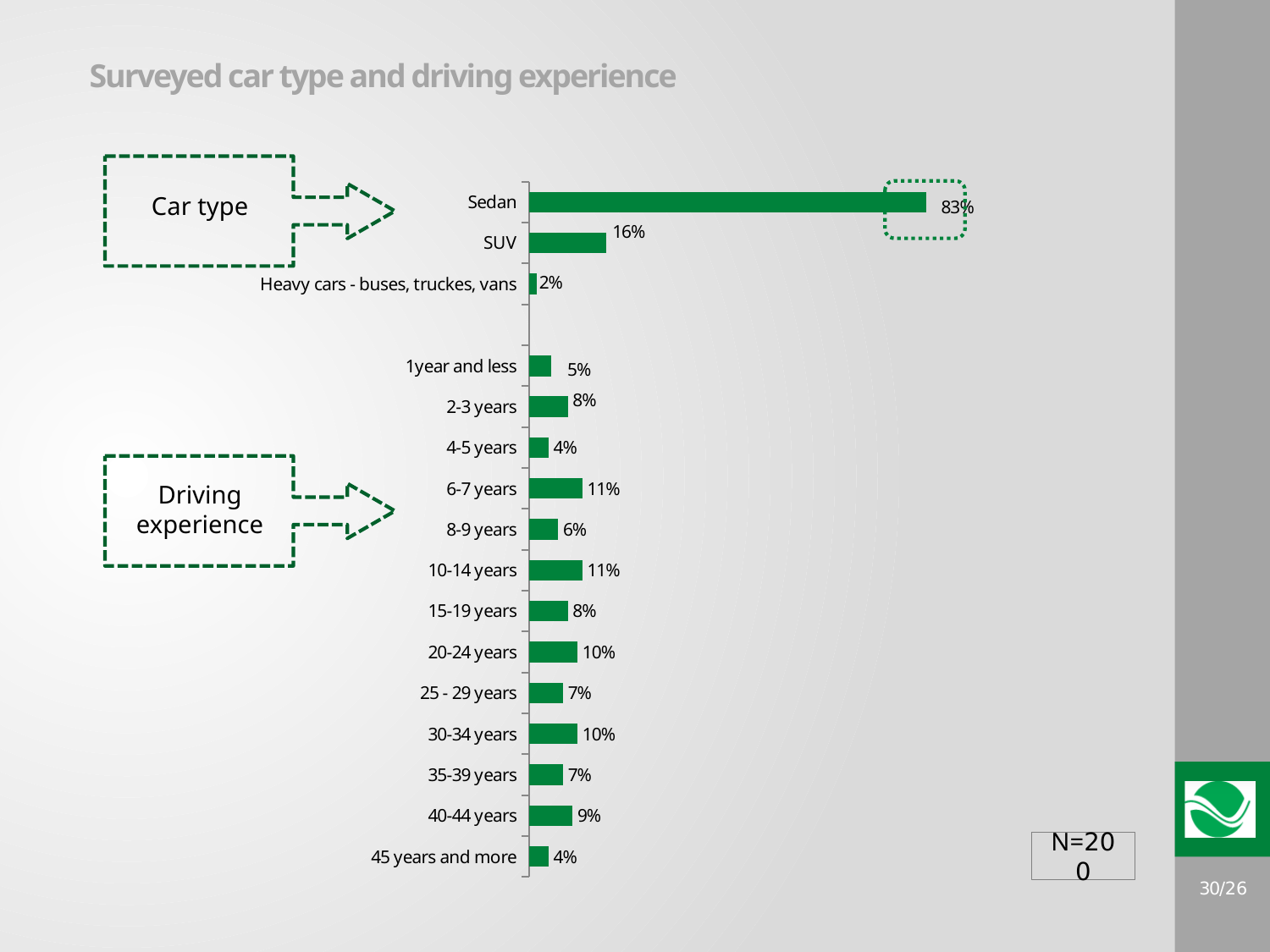
What is the difference between the Sedan and SUV percentages? 67% What is the value shown for SUV? 16% What percentage of surveyed drivers drive a Sedan? 83% What is the title of the slide? Surveyed car type and driving experience What is the value for the '6-7 years' driving experience category? 11% Which car type category has the lowest value? Heavy cars - buses, truckes, vans What percentage is shown for 'Heavy cars - buses, truckes, vans'? 2% Which is larger, the value for '2-3 years' or the value for '4-5 years'? 2-3 years Which car type category has the highest value? Sedan What type of chart is shown on the slide? Bar chart How many driving experience categories are plotted on the chart? 13 What percentage of respondents have '45 years and more' of driving experience? 4%